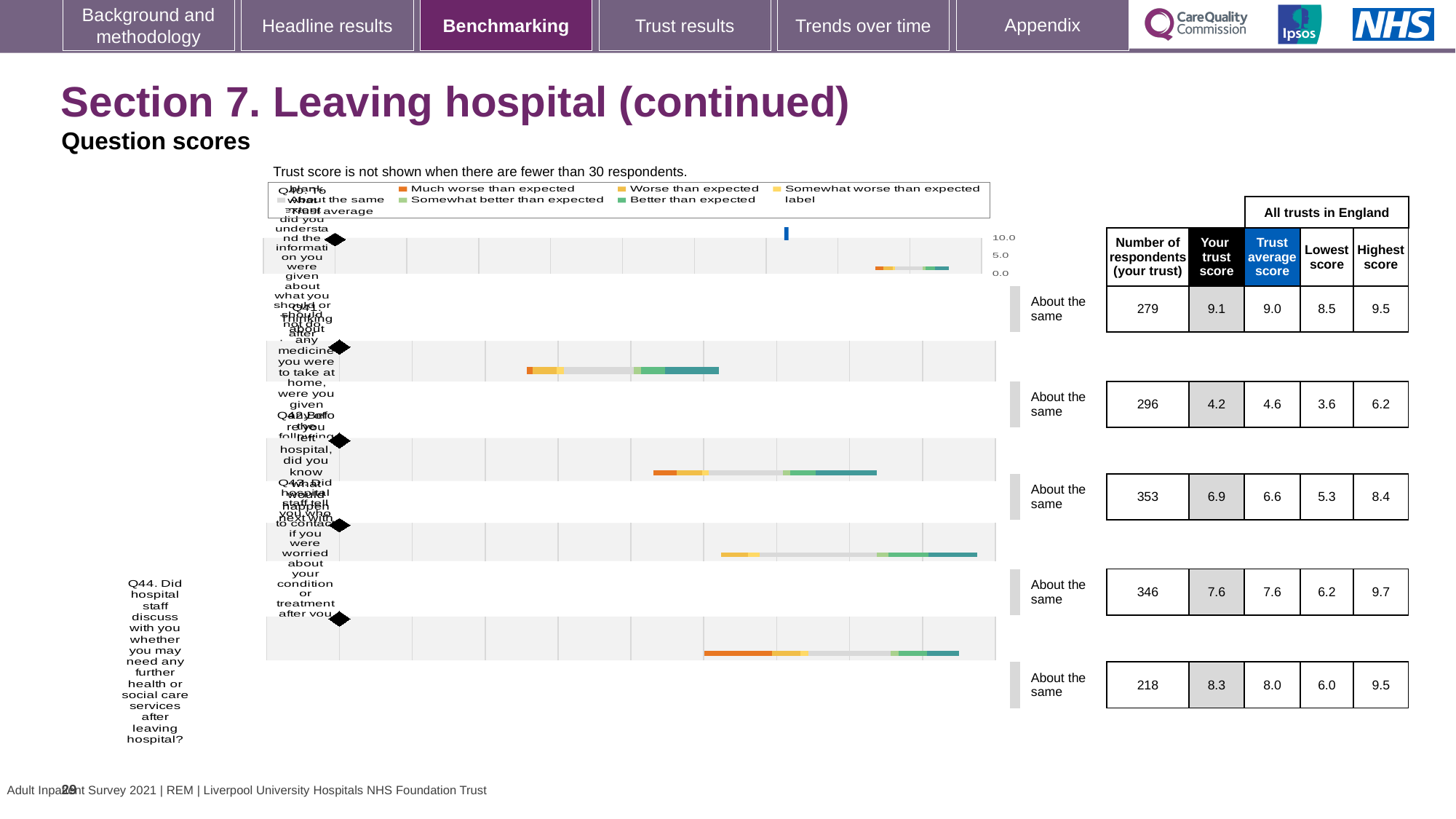
What is the 'Highest score' across all trusts in England for Q44? 9.5 How many question rows are shown in the benchmarking chart and table on this slide? 5 How many respondents (your trust) are shown for Q44 in the table? 218 In the table, what is the 'Your trust score' for Q44 (Did hospital staff discuss with you whether you may need any further health or social care services after leaving hospital?)? 8.3 What is the highest 'Your trust score' value shown in the table on this slide? 9.1 What is the lowest 'Your trust score' value shown in the table on this slide? 4.2 For Q44, which is larger: the 'Your trust score' or the 'Trust average score'? Your trust score What is the 'Lowest score' across all trusts in England for Q44? 6.0 What benchmark category label is shown for Q44 next to the chart? About the same What kind of chart is used to show the question scores on this slide? Bar chart For Q44, what is the difference between the 'Highest score' and the 'Lowest score'? 3.5 What is the 'Trust average score' for Q44 in the table? 8.0